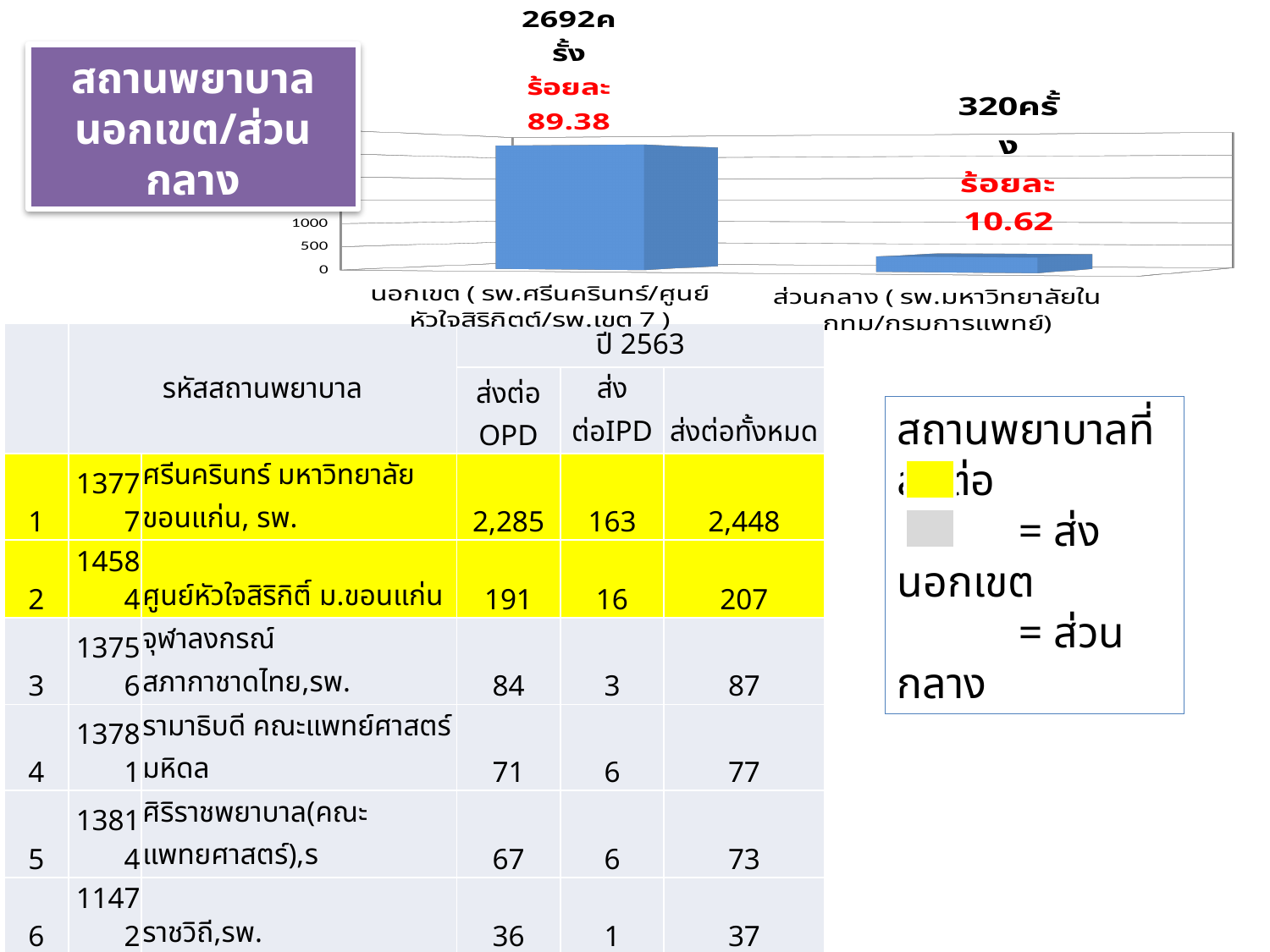
What kind of chart is shown at the top of the slide? bar chart In the bar chart, is the value for ส่วนกลาง greater or less than 500? less How many categories does the bar chart show? 2 In the bar chart, what percentage (ร้อยละ) is labelled for นอกเขต? 89.38 In the bar chart, which is larger: the value for นอกเขต or the value for ส่วนกลาง? นอกเขต In the bar chart, is the value for นอกเขต greater or less than 1000? greater In the bar chart, which category has the lowest value? ส่วนกลาง In the bar chart, what percentage (ร้อยละ) is labelled for ส่วนกลาง? 10.62 In the bar chart, what is the difference in ครั้ง between นอกเขต and ส่วนกลาง? 2372 In the bar chart, which category has the highest value? นอกเขต In the bar chart, how many times (ครั้ง) are shown for ส่วนกลาง (รพ.มหาวิทยาลัยในกทม/กรมการแพทย์)? 320 In the bar chart, how many times (ครั้ง) are shown for นอกเขต (รพ.ศรีนครินทร์/ศูนย์หัวใจสิริกิติ์/รพ.เขต 7)? 2692